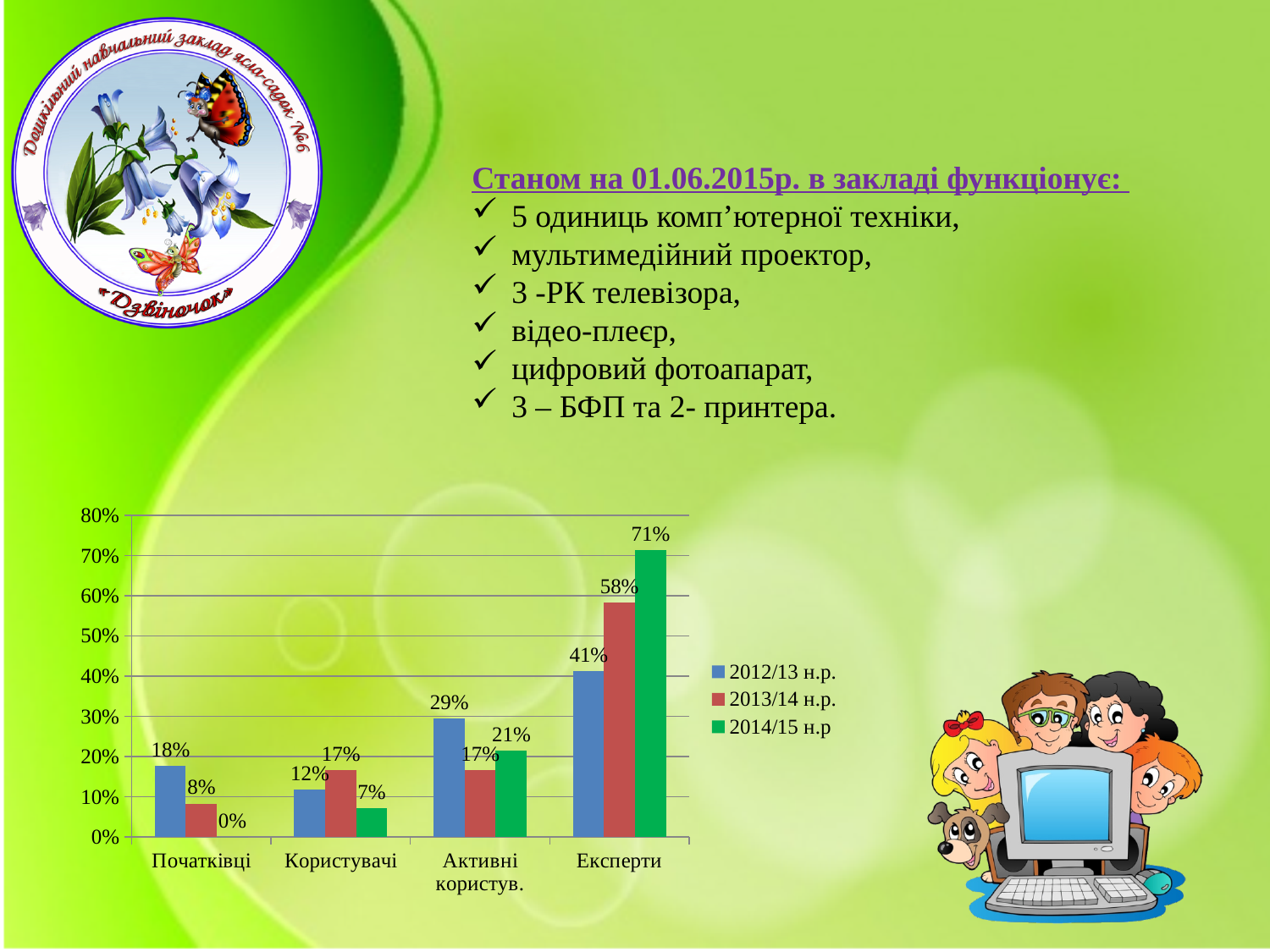
Which is larger for Активні користув.: the 2012/13 н.р. value or the 2013/14 н.р. value? 2012/13 н.р. What is the difference between the 2014/15 н.р and 2012/13 н.р. values for Експерти? 30% Which category has the lowest value in the 2014/15 н.р series? Початківці What is the value for Експерти in the 2014/15 н.р series? 71% What is the value for Користувачі in the 2013/14 н.р. series? 17% What kind of chart is shown on the slide? bar chart Is the value for Експерти in the 2013/14 н.р. series greater or less than 50%? greater Which category has the highest value in the 2013/14 н.р. series? Експерти How many series does the chart legend list? 3 What is the value for Початківці in the 2012/13 н.р. series? 18% What is the value for Активні користув. in the 2014/15 н.р series? 21% How many categories are shown on the x axis of the chart? 4